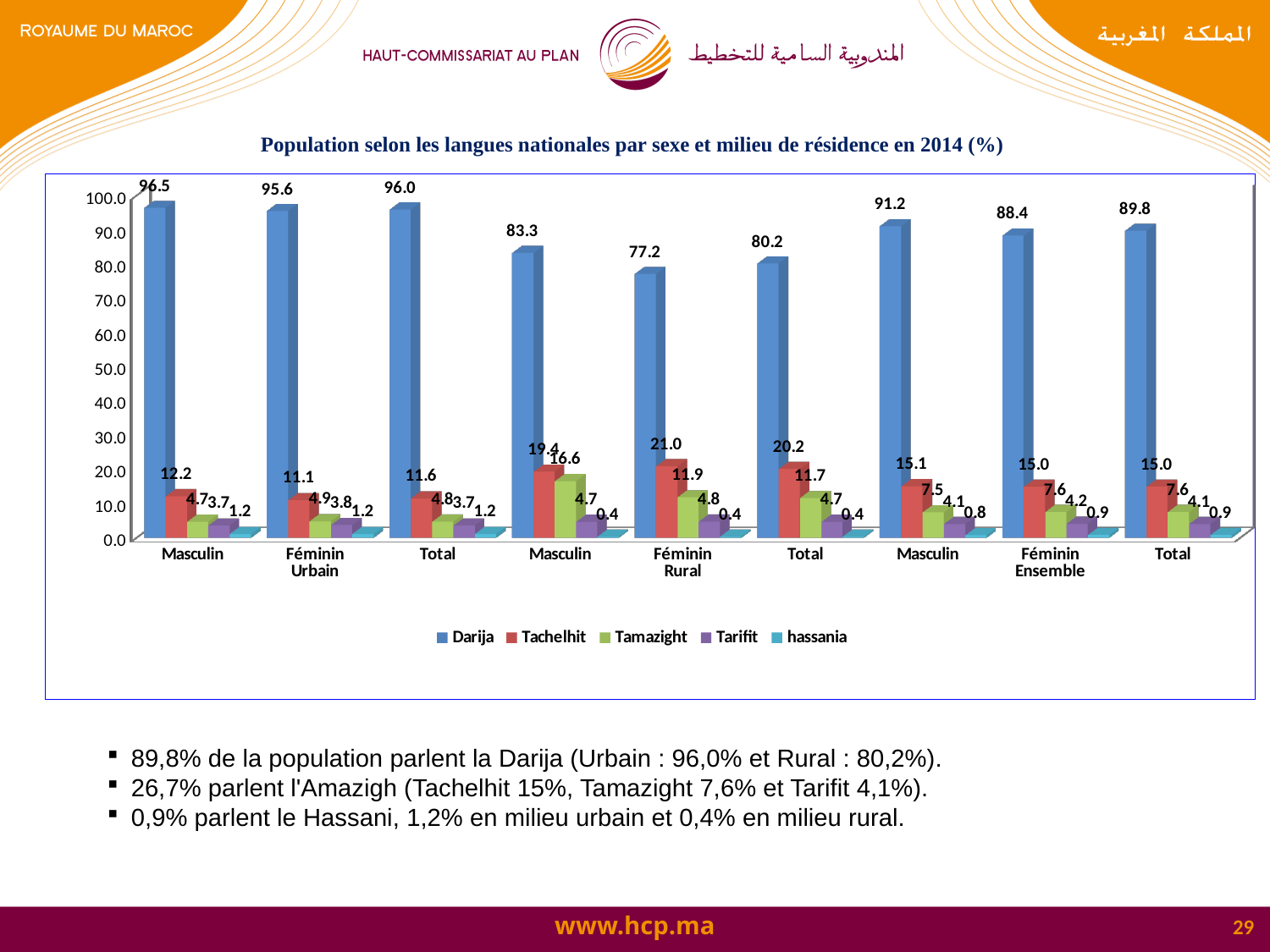
What is the value for hassania for Total in the Ensemble group? 0.9 What type of chart is shown on the slide? Bar chart What is the title of the chart? Population selon les langues nationales par sexe et milieu de résidence en 2014 (%) Is the Darija value for Féminin in the Rural group greater or less than 80.0? less Which category has the lowest Darija value? Féminin (Rural) Which is larger: the Tachelhit value for Masculin Rural or for Masculin Urbain? Masculin Rural What is the value for Tachelhit for Féminin in the Rural group? 21.0 What is the value for Darija for Total in the Urbain group? 96.0 What is the value for Tamazight for Masculin in the Rural group? 16.6 What is the difference between the Darija values for Total Urbain and Total Rural? 15.8 How many series does the legend list? 5 Which category has the highest Darija value? Masculin (Urbain)